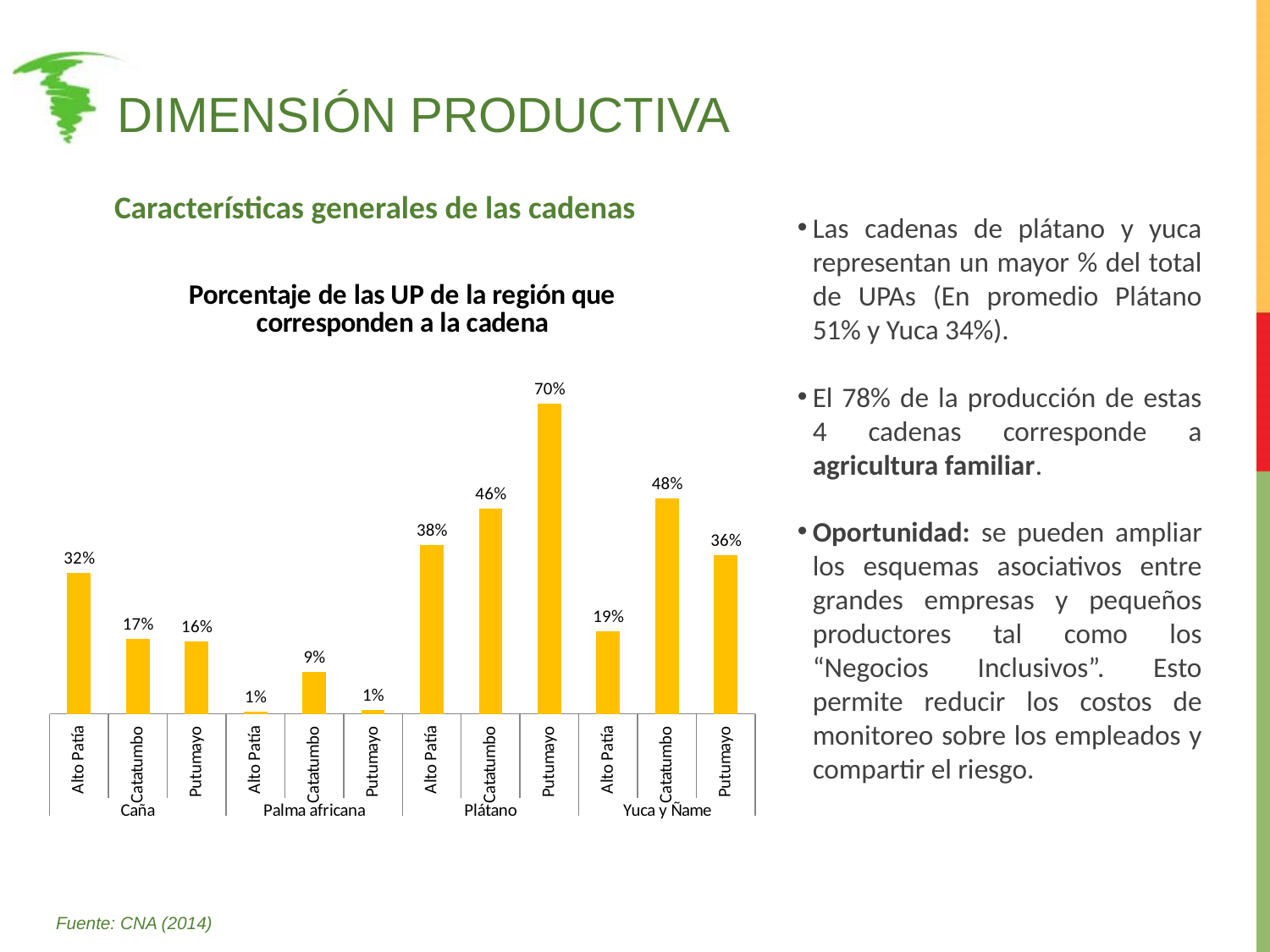
How many bars are plotted in the chart? 12 Which group has the lowest values overall? Palma africana What kind of chart is shown on the slide? Bar chart How many chain groups are shown on the x axis? 4 Which bar has the highest value in the chart? Putumayo (Plátano) What is the value for Putumayo in the Plátano group? 70% Which is larger: Catatumbo in the Caña group or Catatumbo in the Yuca y Ñame group? Catatumbo in Yuca y Ñame What is the title of the chart? Porcentaje de las UP de la región que corresponden a la cadena What is the difference between Putumayo and Alto Patía in the Plátano group? 32% What is the value for Catatumbo in the Yuca y Ñame group? 48% What is the value for Alto Patía in the Caña group? 32% What is the value for Catatumbo in the Palma africana group? 9%